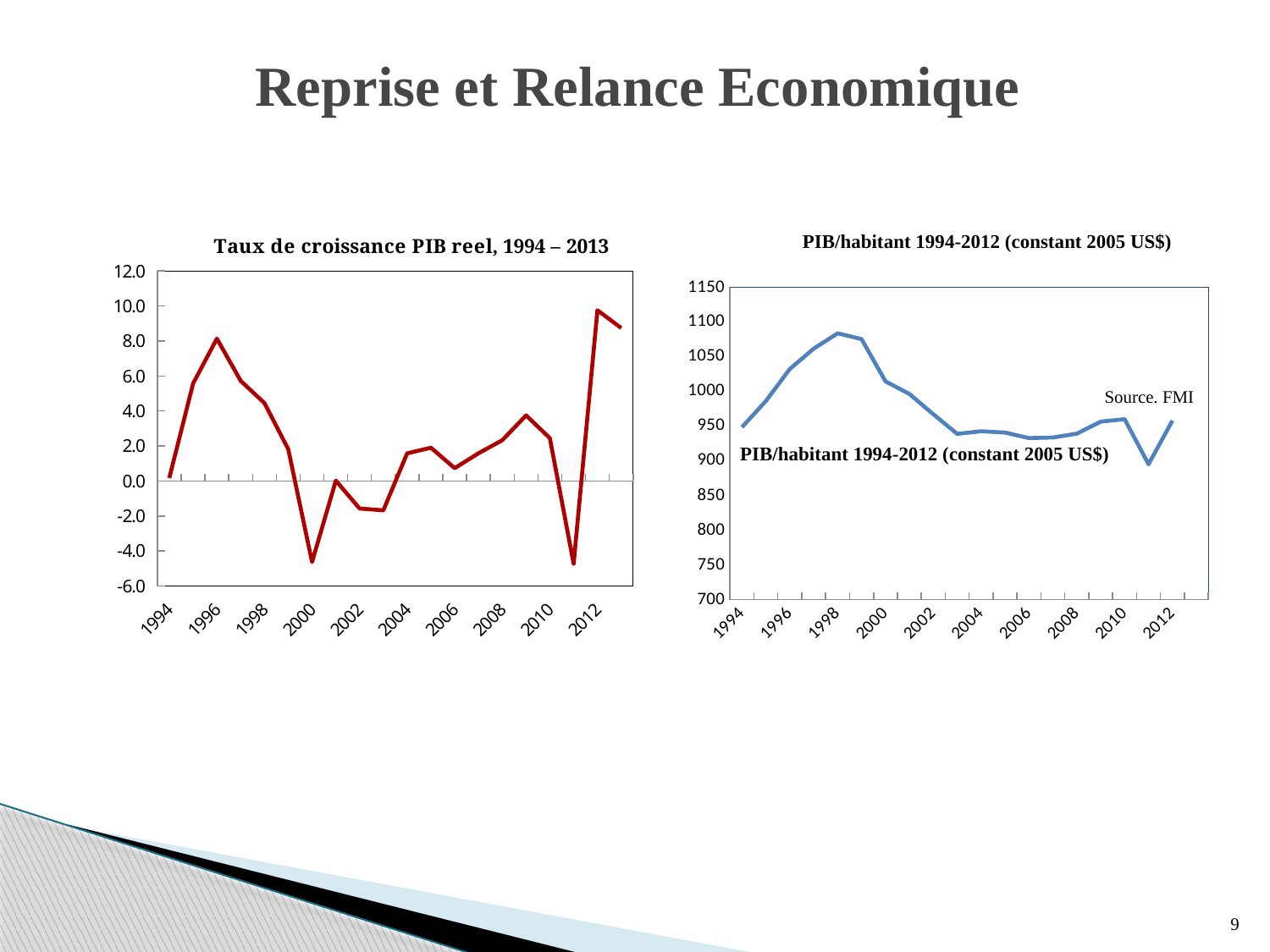
In the 'PIB/habitant 1994-2012 (constant 2005 US$)' chart, which year has the highest value? 1998 In the 'PIB/habitant 1994-2012 (constant 2005 US$)' chart, does the value rise or fall from 1998 to 2003? fall What source is cited on the 'PIB/habitant 1994-2012 (constant 2005 US$)' chart? FMI What kind of chart is the 'PIB/habitant 1994-2012 (constant 2005 US$)' chart? line chart In the 'Taux de croissance PIB reel, 1994 – 2013' chart, which year has the highest growth rate? 2012 In the 'Taux de croissance PIB reel, 1994 – 2013' chart, is the value for 2000 greater or less than -4.0? less In the 'PIB/habitant 1994-2012 (constant 2005 US$)' chart, is the value for 1994 greater or less than 1000? less In the 'PIB/habitant 1994-2012 (constant 2005 US$)' chart, which year has the lowest value? 2011 In the 'Taux de croissance PIB reel, 1994 – 2013' chart, does the growth rate rise or fall from 1996 to 2000? fall In the 'PIB/habitant 1994-2012 (constant 2005 US$)' chart, is the value for 1998 greater or less than 1050? greater What kind of chart is the 'Taux de croissance PIB reel, 1994 – 2013' chart? line chart